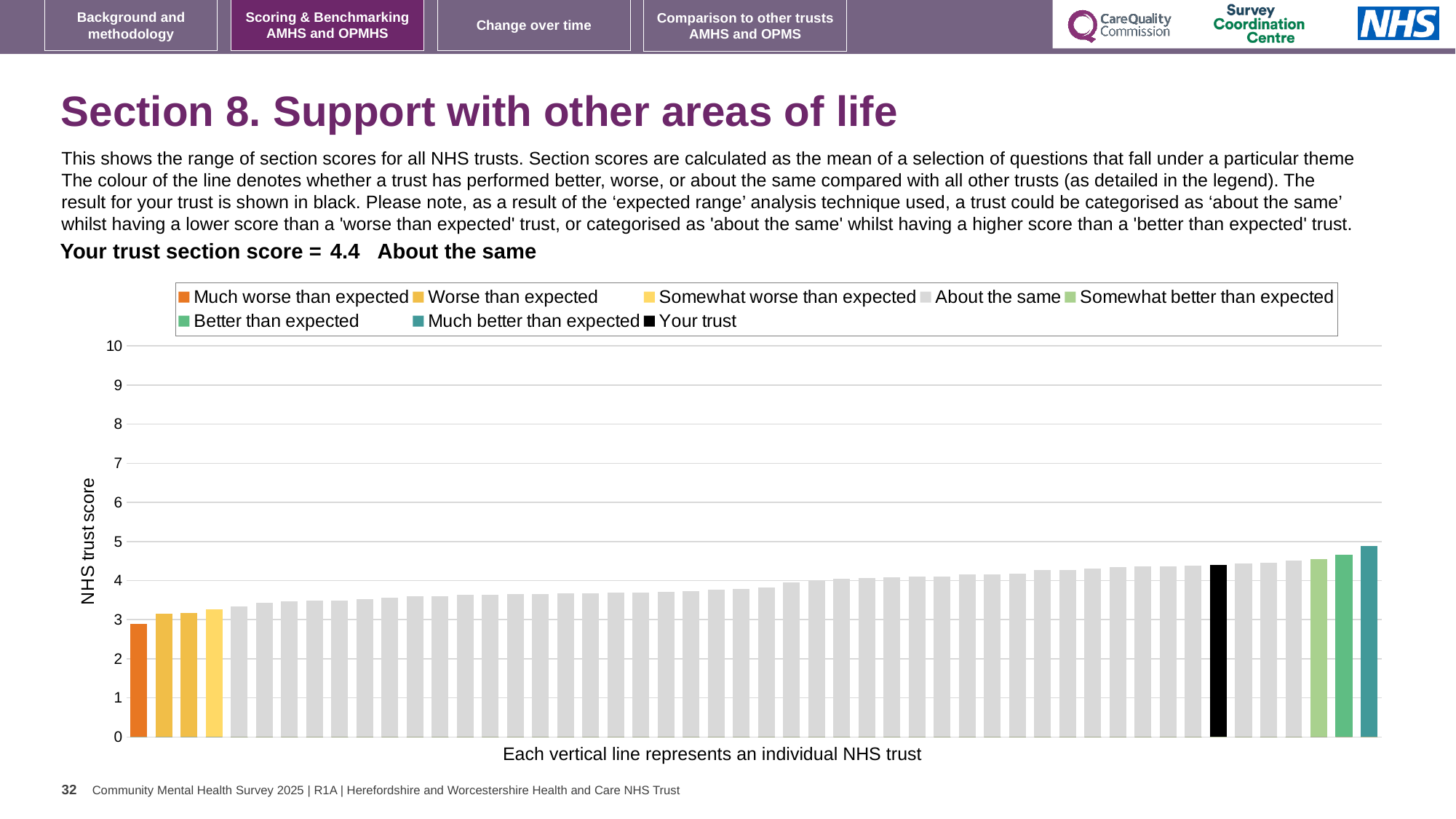
Which category is your trust placed in for this section? About the same Is the value of the rightmost teal bar greater or less than 4? greater What kind of chart is shown on the slide? Bar chart Which is taller, the black 'Your trust' bar or the orange 'Much worse than expected' bar? The black 'Your trust' bar Do the bar values rise or fall from left to right along the x axis? Rise What is the section score for your trust shown on the slide? 4.4 Which legend category does the tallest bar belong to? Much better than expected Is the value of the black 'Your trust' bar greater or less than 4? greater What is the label on the vertical axis of the chart? NHS trust score Is the value of the leftmost orange bar greater or less than 2? greater How many entries does the chart legend list? 8 Which legend category does the shortest bar belong to? Much worse than expected